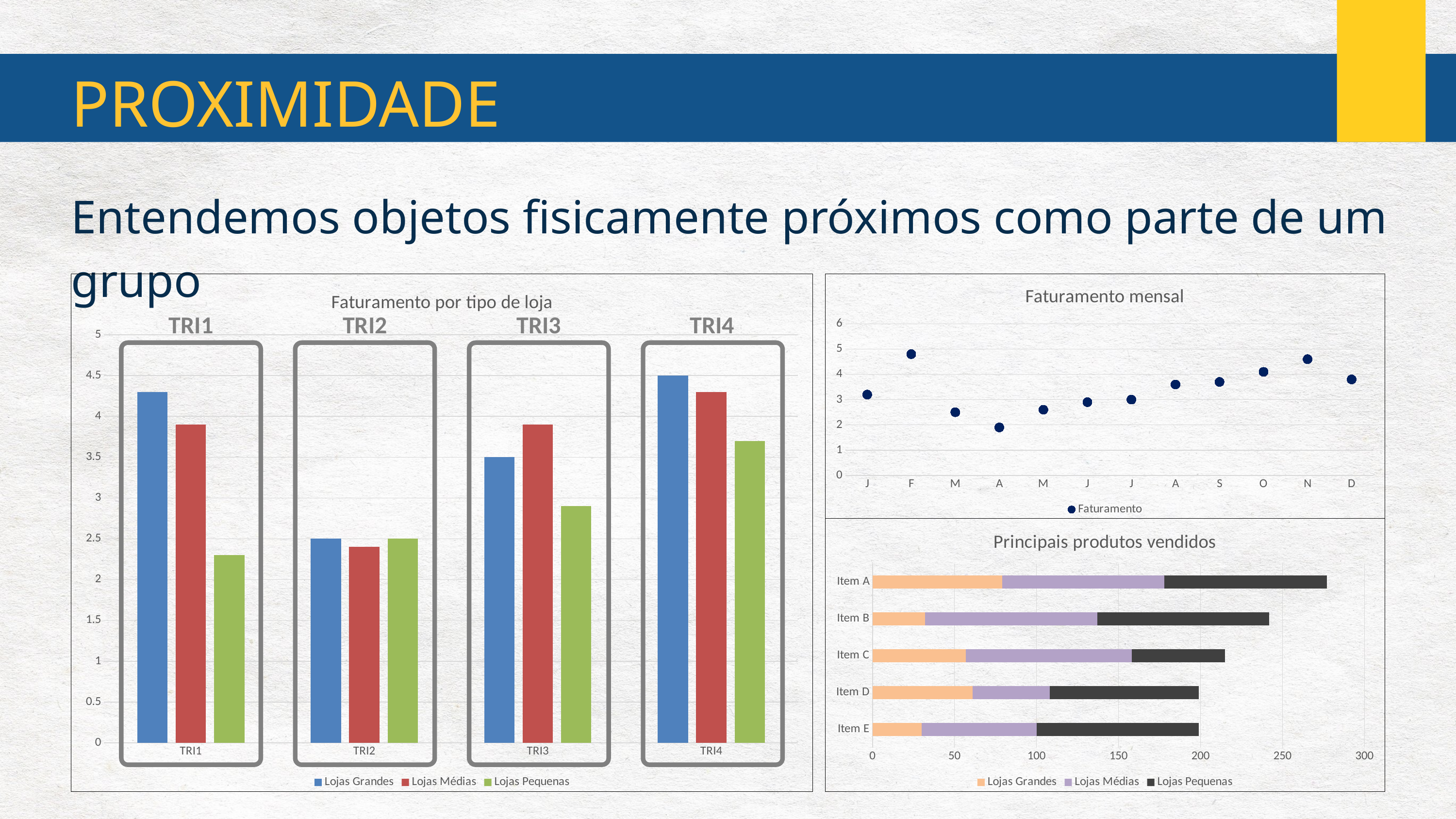
How many series does the legend of "Faturamento por tipo de loja" list? 3 In "Faturamento por tipo de loja", how many quarters (categories) are shown on the x axis? 4 In "Principais produtos vendidos", how many items are listed on the vertical axis? 5 In "Faturamento mensal", do the values rise or fall from A to N? rise In "Faturamento por tipo de loja", is the value for Lojas Grandes in TRI1 greater or less than 4? greater In "Faturamento mensal", how many data points are plotted? 12 In "Faturamento por tipo de loja", which quarter has the lowest value for Lojas Grandes? TRI2 In "Principais produtos vendidos", which item has the longest total bar? Item A In "Faturamento por tipo de loja", which is larger: Lojas Grandes in TRI1 or Lojas Grandes in TRI3? Lojas Grandes in TRI1 In "Faturamento mensal", which month has the lowest value? A What kind of chart is "Faturamento por tipo de loja"? bar chart In "Faturamento por tipo de loja", is the value for Lojas Pequenas in TRI1 greater or less than 2.5? less